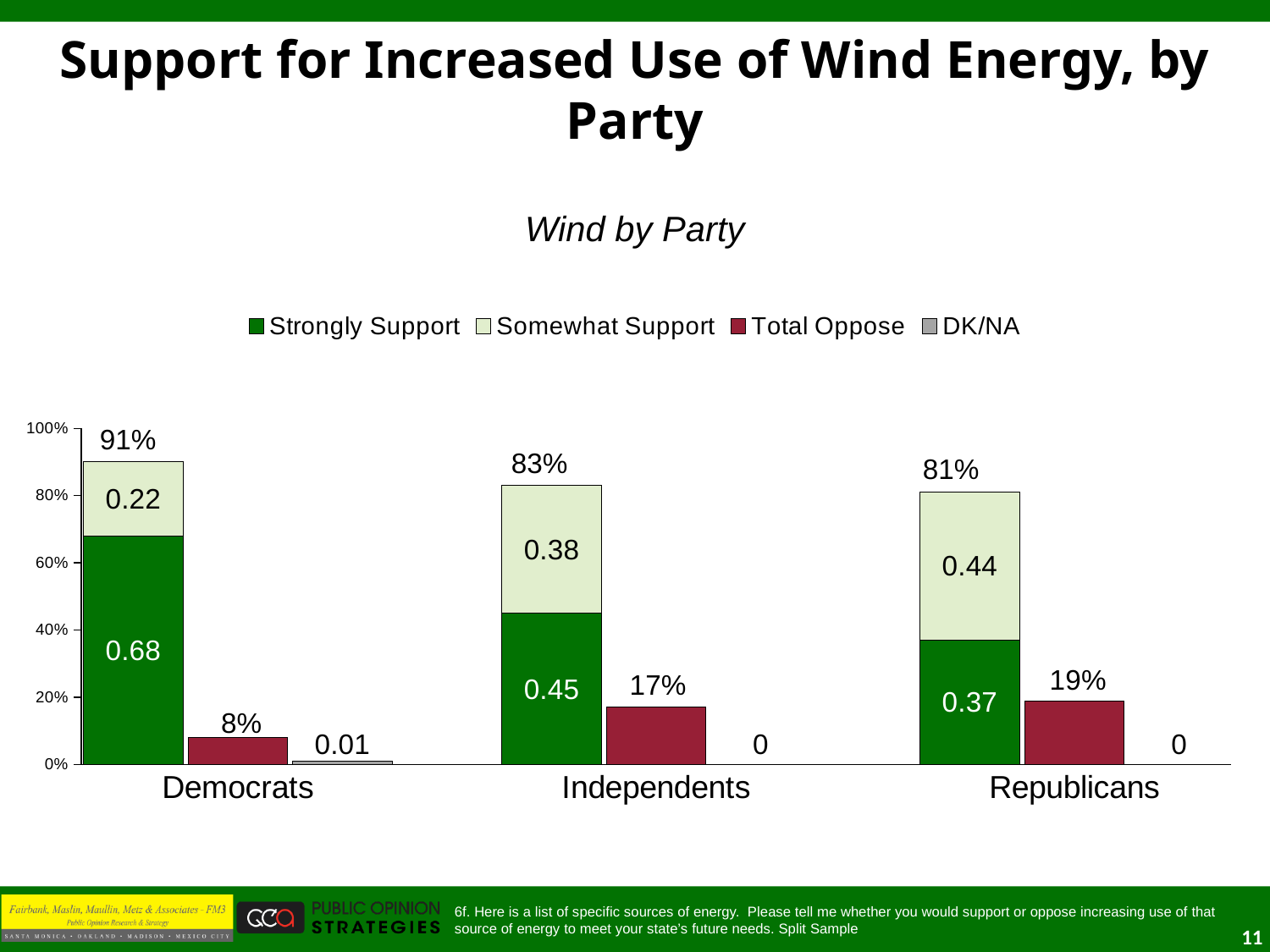
What is the Total Oppose value for Independents? 17% Which is larger for Republicans: Strongly Support or Somewhat Support? Somewhat Support What kind of chart is shown on the slide? Bar chart How many series does the legend list? 4 What total support percentage is shown above the stacked bar for Independents? 83% What is the Strongly Support value for Democrats? 0.68 How many party categories are shown on the x axis? 3 Which party has the lowest Total Oppose value? Democrats What is the DK/NA value for Democrats? 0.01 What is the Somewhat Support value for Republicans? 0.44 Which party has the highest Strongly Support value? Democrats What is the difference between the Total Oppose values for Republicans and Democrats? 11 percentage points